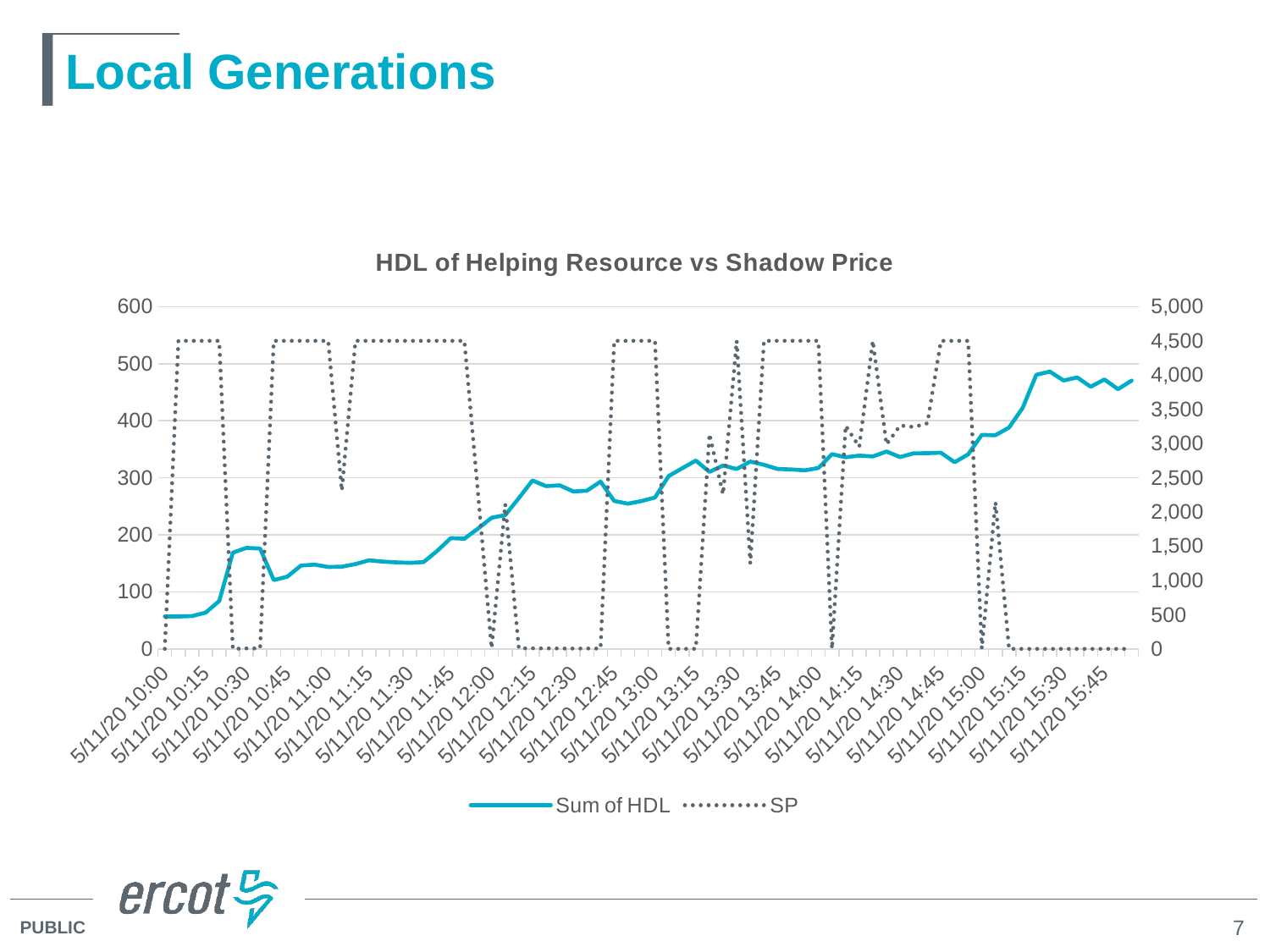
What is the title of the chart? HDL of Helping Resource vs Shadow Price Does the Sum of HDL series generally rise or fall from 5/11/20 10:00 to 5/11/20 15:45? rise What kind of chart is shown on the slide? line chart How many series does the legend list? 2 Is the value of SP at 5/11/20 10:15 greater or less than 4,000? greater Is the value of Sum of HDL at 5/11/20 10:00 greater or less than 100? less Is the value of Sum of HDL at 5/11/20 15:45 greater or less than 400? greater Which series is drawn with a dotted line? SP How many time labels are shown on the x axis? 24 Which is larger, the Sum of HDL at 5/11/20 15:45 or at 5/11/20 10:00? 5/11/20 15:45